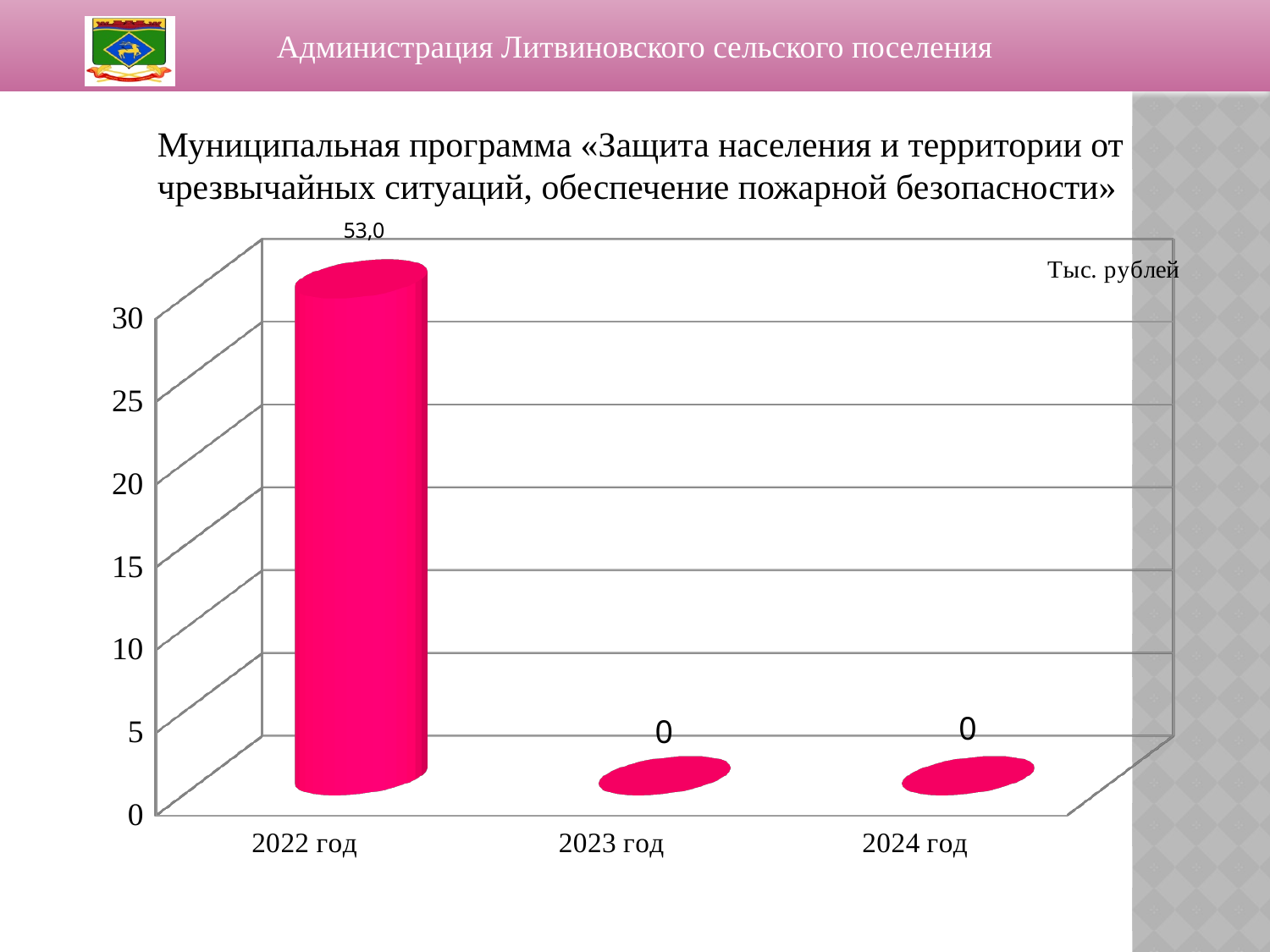
Which is larger, the value for 2022 год or the value for 2024 год? 2022 год What kind of chart is shown on the slide? bar chart What is the value for 2022 год? 53,0 What unit of measurement is indicated on the chart? Тыс. рублей Which year has the highest value? 2022 год What is the value for 2023 год? 0 What is the value for 2024 год? 0 What is the difference between the values for 2022 год and 2023 год? 53,0 Do the values rise or fall from 2022 год to 2024 год? fall How many years are shown on the x axis? 3 What is the total of the values for all three years? 53,0